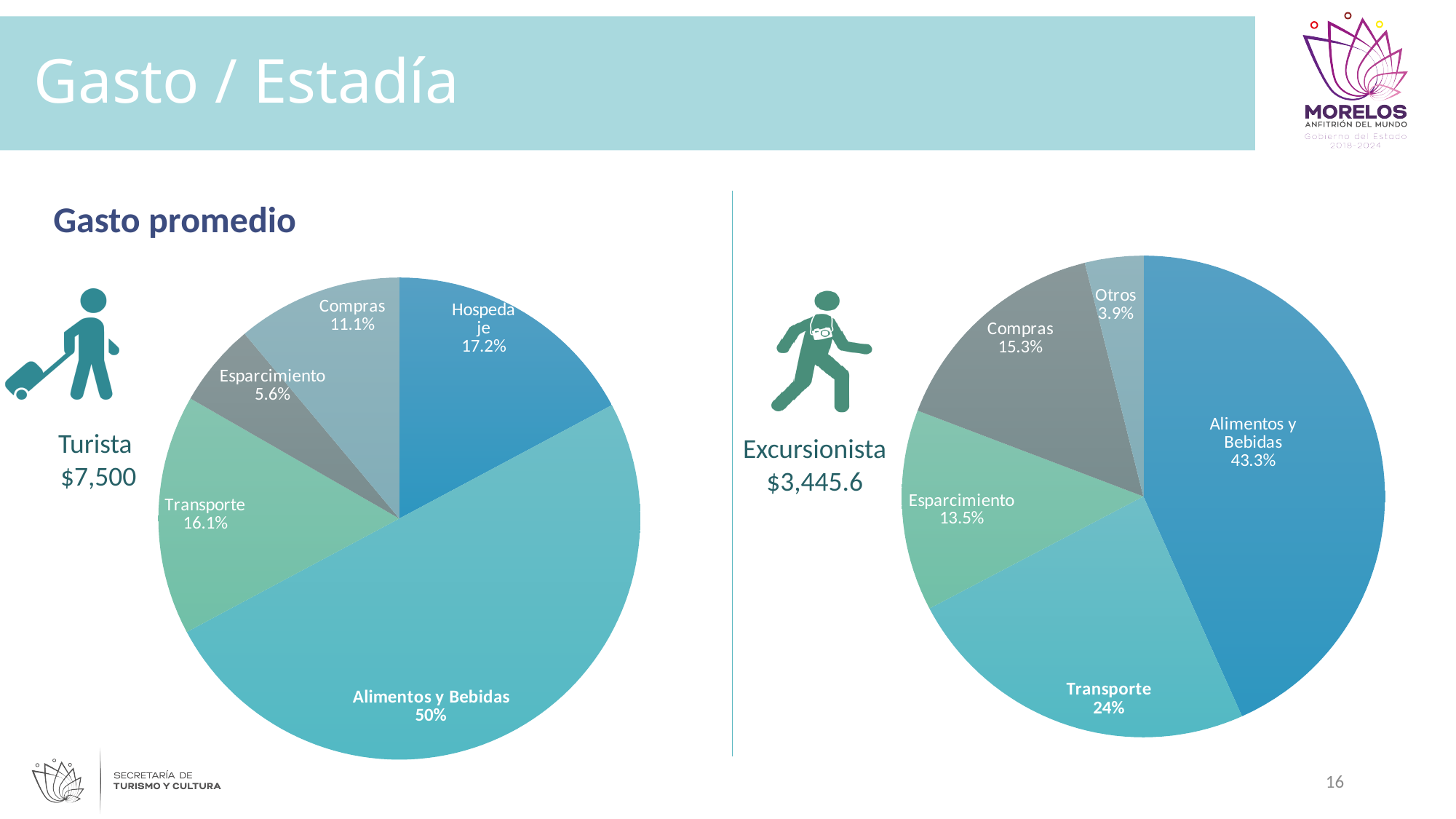
In the Turista pie chart, what is the value for Hospedaje? 17.2% What is the average spend (gasto promedio) shown for Excursionista? $3,445.6 In the Turista pie chart, what is the difference between Transporte and Compras? 5% In the Excursionista pie chart, how many slices are there? 5 What type of chart is used for the Turista data? Pie chart In the Turista pie chart, how many slices are there? 5 In the Turista pie chart, what share does Alimentos y Bebidas have? 50% In the Excursionista pie chart, what share does Transporte have? 24% In the Excursionista pie chart, which category has the largest share? Alimentos y Bebidas In the Excursionista pie chart, which category has the smallest share? Otros In the Excursionista pie chart, which is larger, Compras or Esparcimiento? Compras In the Turista pie chart, which category has the smallest share? Esparcimiento